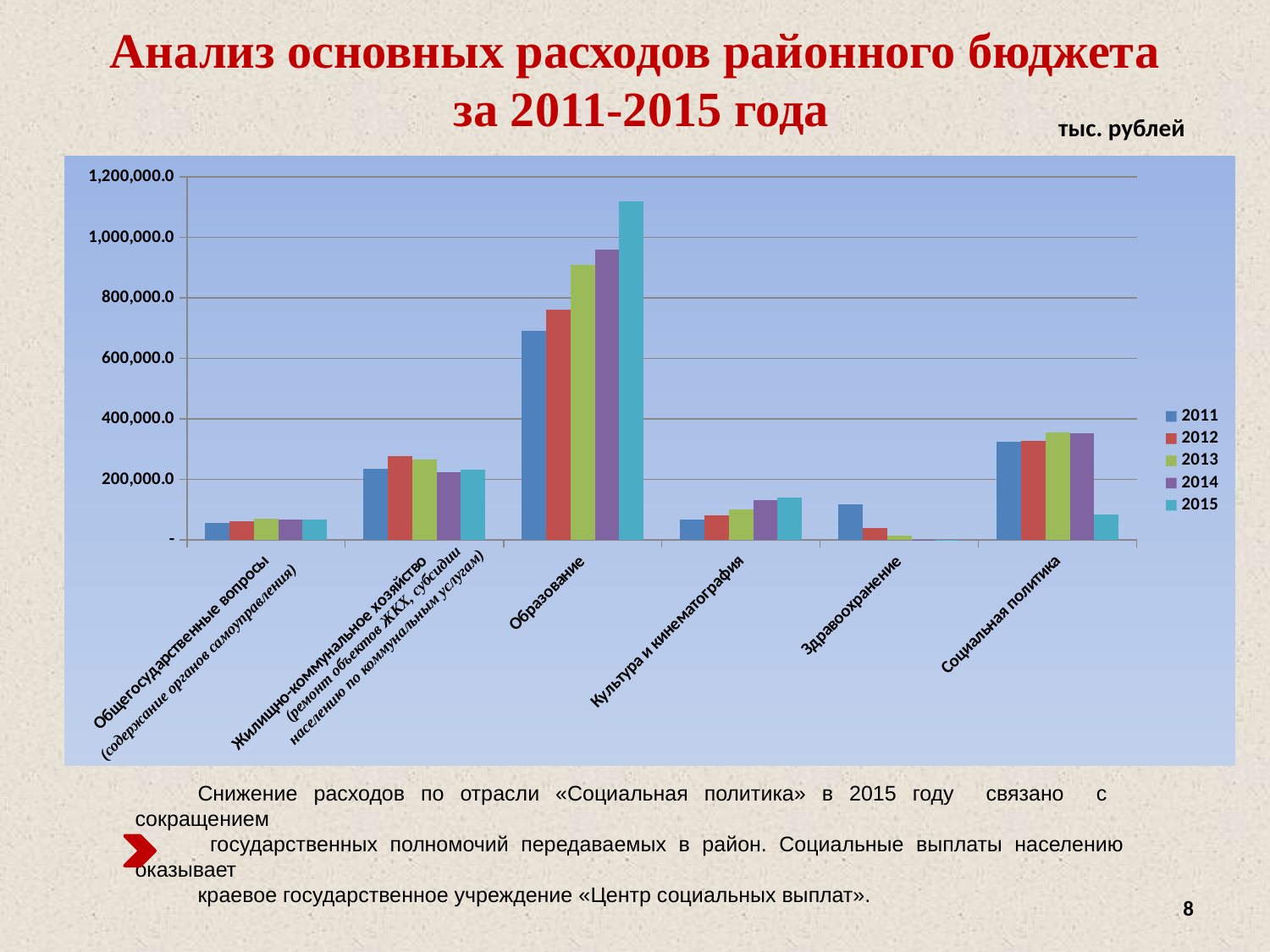
Is the value for Жилищно-коммунальное хозяйство in 2012 greater or less than 200,000.0? greater Do the values for Образование rise or fall from 2011 to 2015? rise Is the value for Образование in 2015 greater or less than 1,000,000.0? greater How many categories are shown along the x axis of the chart? 6 What kind of chart is shown on the slide? bar chart Which years are listed in the chart's legend? 2011, 2012, 2013, 2014, 2015 How many series does the chart's legend list? 5 Which category has the highest bars in the chart? Образование Is the value for Образование in 2011 greater or less than 600,000.0? greater For Социальная политика, which is larger: the value for 2011 or the value for 2015? 2011 Within the category Образование, which year has the highest value? 2015